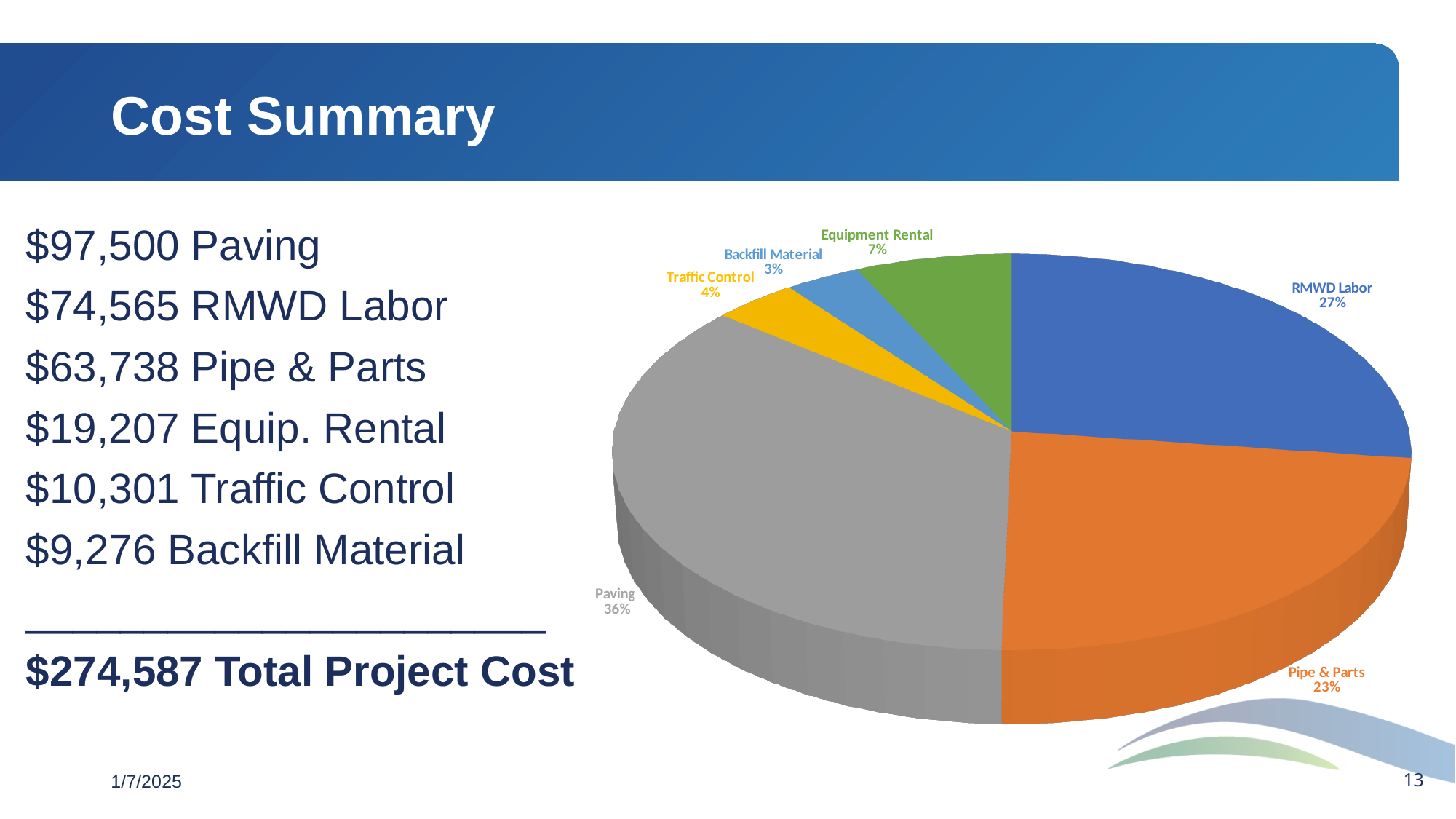
What percentage share does Backfill Material have in the pie chart? 3% What kind of chart is shown on the slide? pie chart Which slice is larger, Traffic Control or Equipment Rental? Equipment Rental What colour is the Paving slice in the pie chart? gray What percentage share does RMWD Labor have in the pie chart? 27% What percentage share does Pipe & Parts have in the pie chart? 23% Which category has the largest slice in the pie chart? Paving How many slices does the pie chart have? 6 Which category has the smallest slice in the pie chart? Backfill Material What is the difference in percentage points between the Paving and RMWD Labor slices? 9